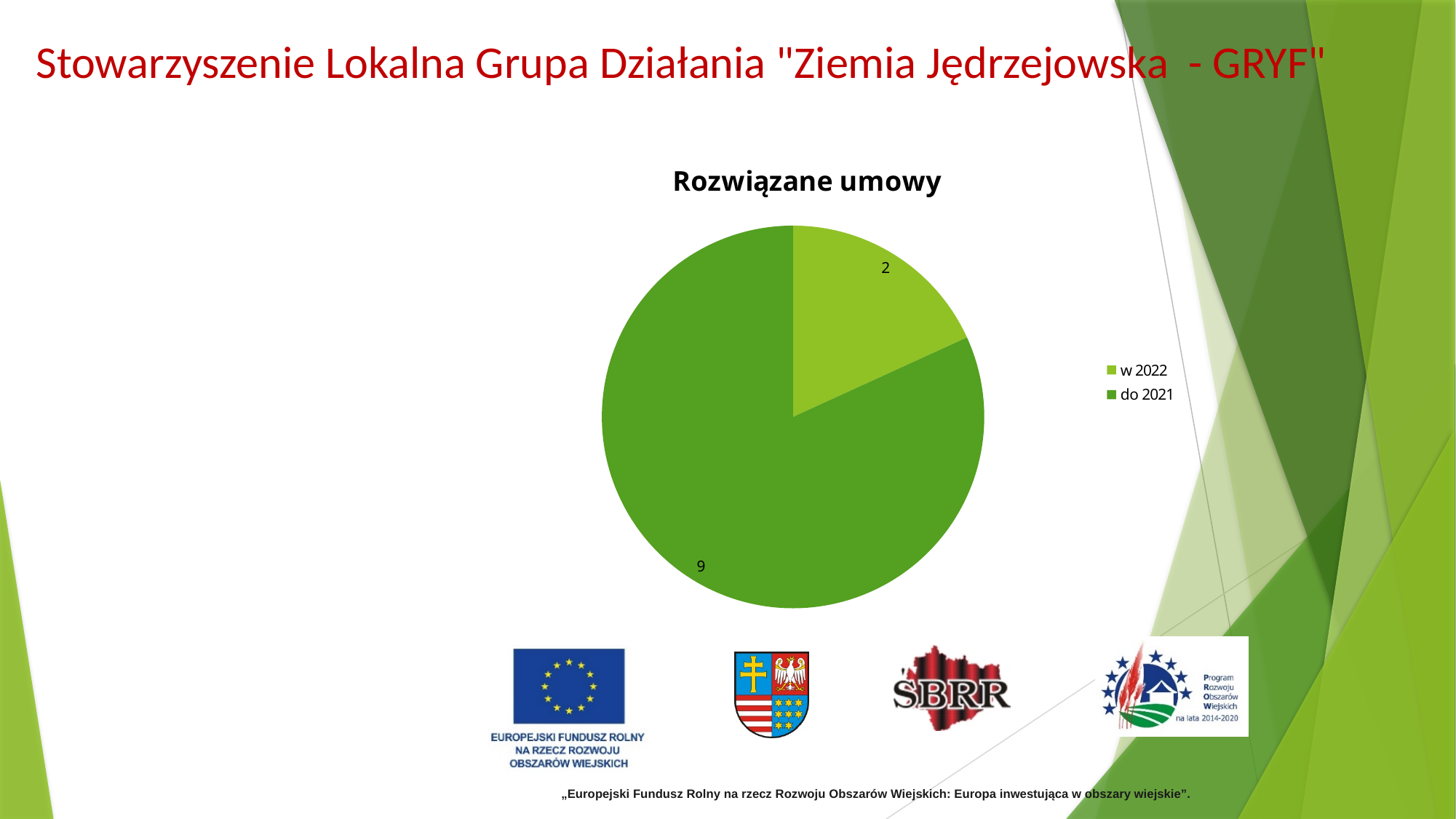
What is the value for the 'w 2022' slice? 2 What is the title of the chart? Rozwiązane umowy What is the total of all slices in the pie chart? 11 Which category has the largest slice of the pie? do 2021 Which category has the smallest slice of the pie? w 2022 What is the value for the 'do 2021' slice? 9 How many slices does the pie chart have? 2 What type of chart is shown on the slide? pie chart Which legend entry is shown in the darker green colour? do 2021 Which is larger, the value for 'w 2022' or the value for 'do 2021'? do 2021 How many entries does the legend list? 2 What is the difference between the values for 'do 2021' and 'w 2022'? 7